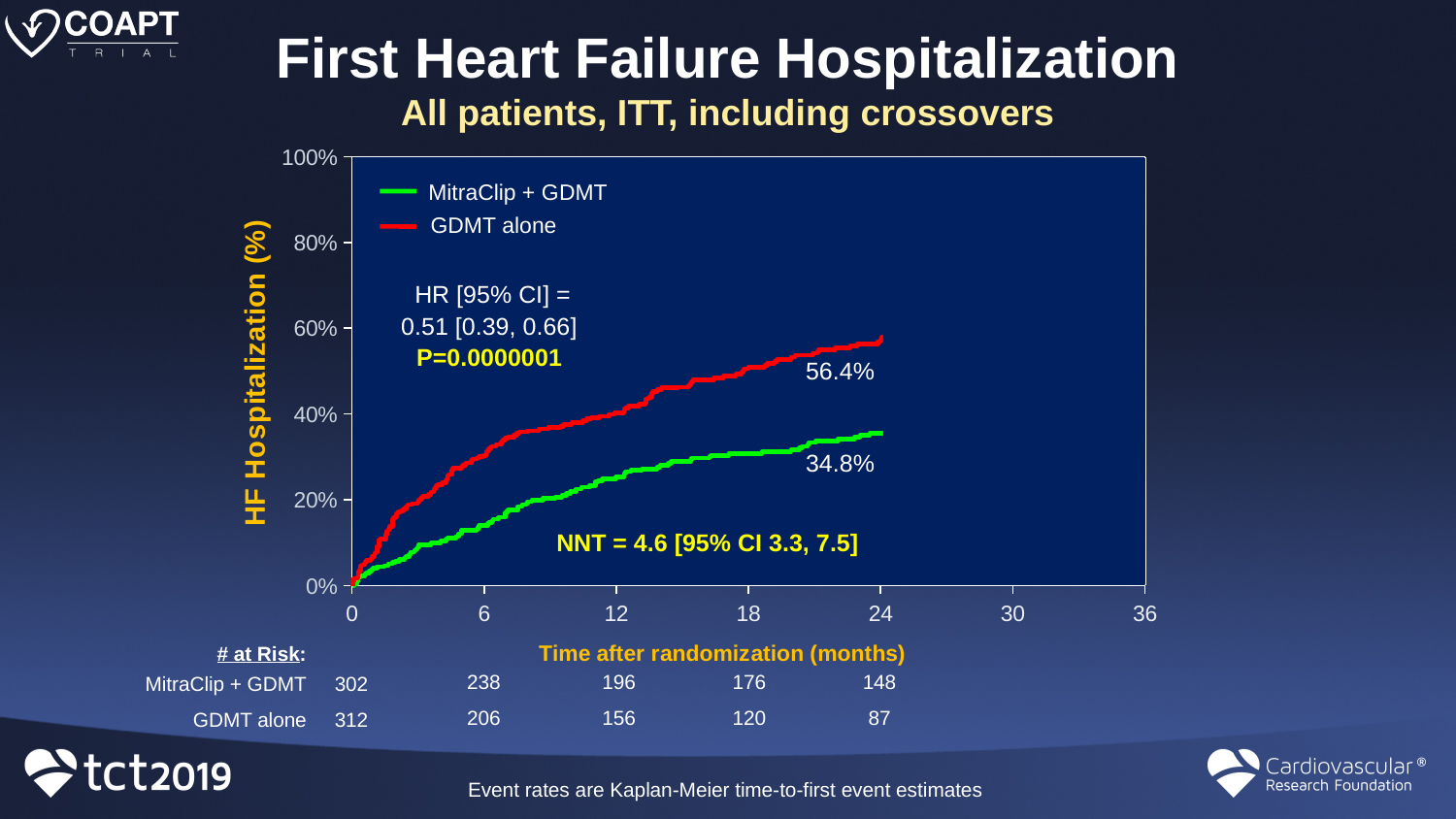
Do the HF hospitalization curves rise or fall over time after randomization? Rise Which group has the higher HF hospitalization rate at 24 months, MitraClip + GDMT or GDMT alone? GDMT alone How many patients were at risk in the GDMT alone group at 24 months? 87 How many patients were at risk in the MitraClip + GDMT group at 0 months? 302 What is the HF hospitalization rate for MitraClip + GDMT at 24 months? 34.8% What is the HF hospitalization rate for GDMT alone at 24 months? 56.4% What hazard ratio with 95% CI is reported on the chart? 0.51 [0.39, 0.66] What is the difference in HF hospitalization rate at 24 months between GDMT alone and MitraClip + GDMT? 21.6% How many series does the legend list? 2 Is the HF hospitalization rate for GDMT alone at 6 months greater or less than 20%? greater What kind of chart is shown on the slide? Line chart (Kaplan-Meier curve) Is the HF hospitalization rate for MitraClip + GDMT at 12 months greater or less than 40%? less